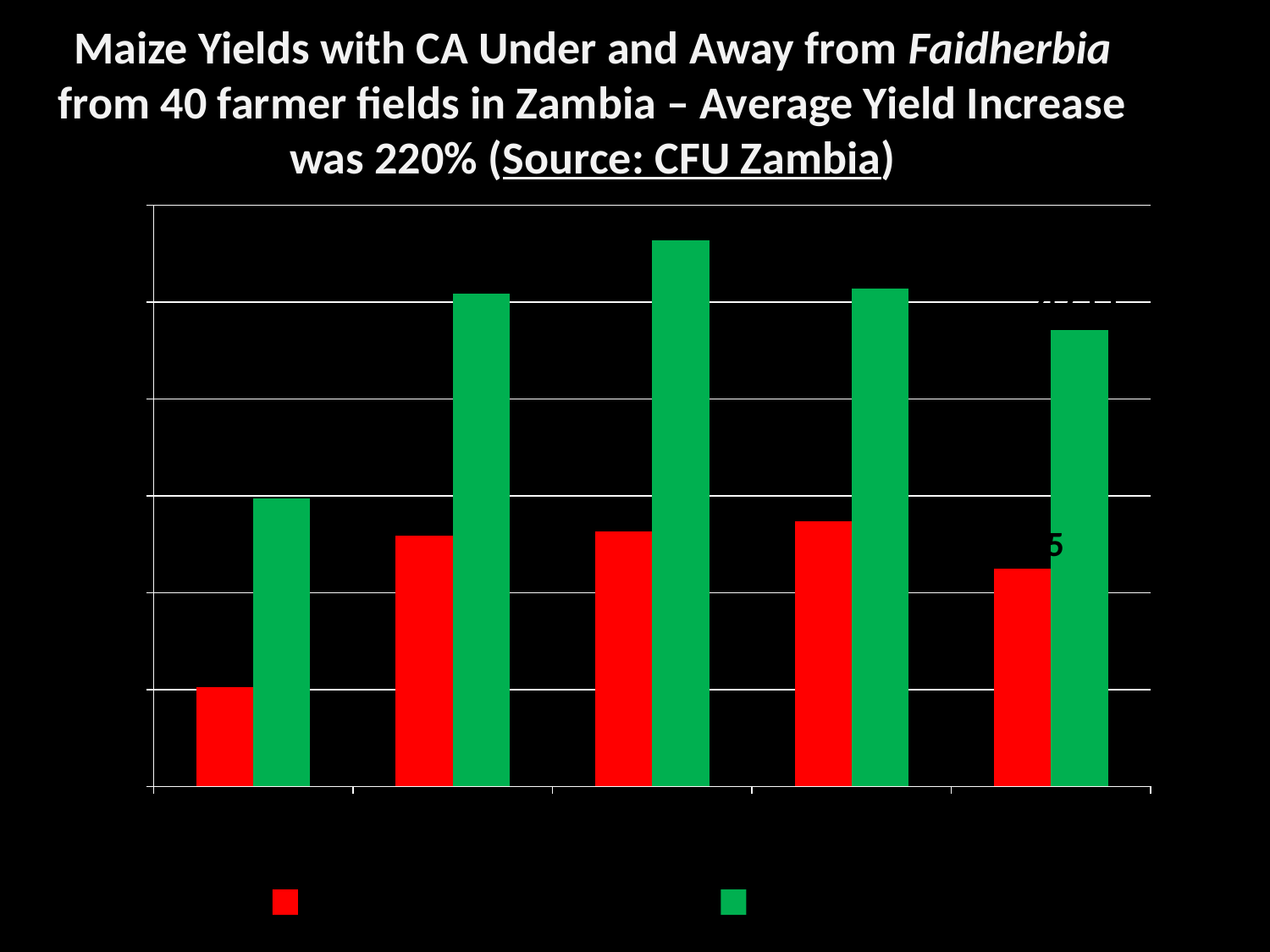
What colours are the two series of bars? red and green In each group of bars, which bar is taller, the red one or the green one? the green one Counting from the left, which group has the tallest green bar? the third group Counting from the left, which group has the shortest red bar? the first group How many groups of bars (categories) are plotted along the x axis? 5 How many series does the legend list? 2 According to the chart title, what was the average yield increase? 220% Counting from the left, which group has the shortest green bar? the first group What kind of chart is shown on the slide? bar chart